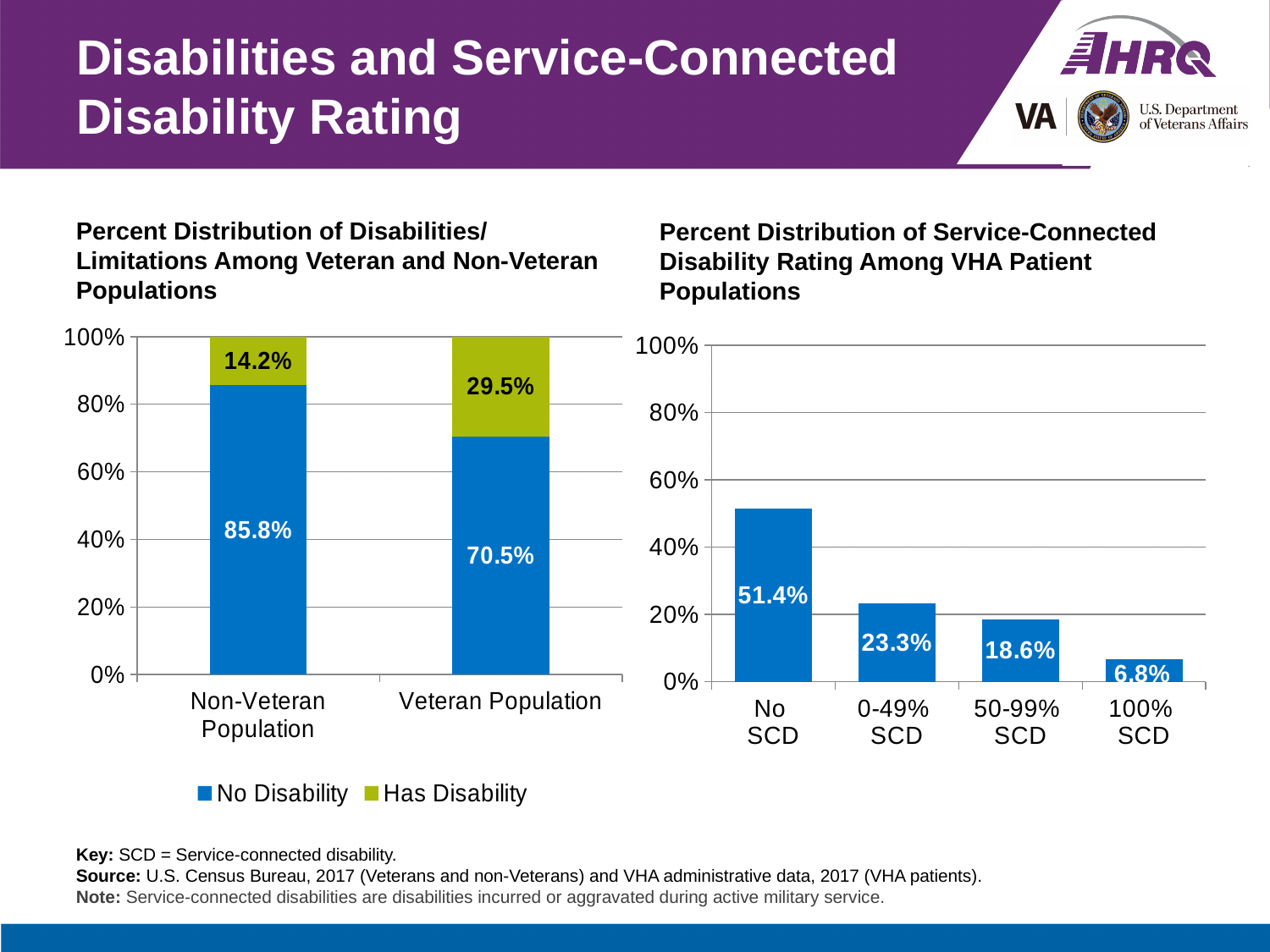
In the left chart, what is the difference between the Has Disability values for the Veteran Population and the Non-Veteran Population? 15.3% What kind of chart is the right chart? Bar chart In the right chart, how many categories are shown on the x axis? 4 In the left chart, how many series does the legend list? 2 In the right chart (Percent Distribution of Service-Connected Disability Rating Among VHA Patient Populations), what is the value for 50-99% SCD? 18.6% In the left chart, what is the total of the stacked bar for the Veteran Population? 100% In the left chart (Percent Distribution of Disabilities/Limitations Among Veteran and Non-Veteran Populations), what is the Has Disability value for the Veteran Population? 29.5% In the left chart, which population has the larger No Disability share, Non-Veteran Population or Veteran Population? Non-Veteran Population In the right chart, which category has the lowest value? 100% SCD In the left chart, what is the No Disability value for the Non-Veteran Population? 85.8% In the right chart, what is the difference between the values for No SCD and 0-49% SCD? 28.1% In the right chart, which category has the highest value? No SCD